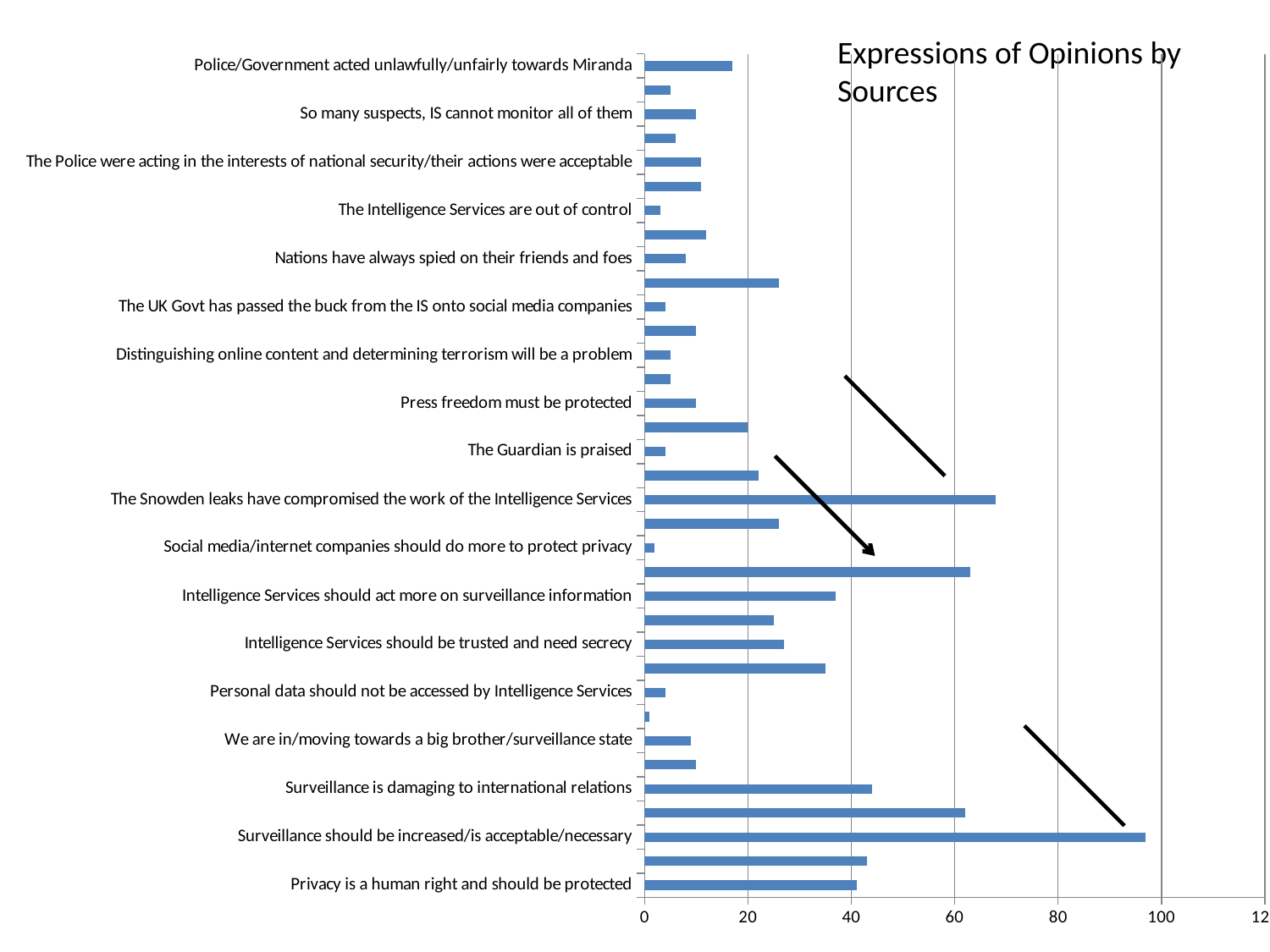
Is the value for "Privacy is a human right and should be protected" greater or less than 20? greater Is the value for "Social media/internet companies should do more to protect privacy" greater or less than 20? less What kind of chart is shown on the slide? bar chart Is the value for "The Intelligence Services are out of control" greater or less than 20? less Which has the larger value: "The Snowden leaks have compromised the work of the Intelligence Services" or "Surveillance is damaging to international relations"? The Snowden leaks have compromised the work of the Intelligence Services Which labelled opinion has the highest value? Surveillance should be increased/is acceptable/necessary Which has the larger value: "Surveillance should be increased/is acceptable/necessary" or "Privacy is a human right and should be protected"? Surveillance should be increased/is acceptable/necessary What is the title of the chart? Expressions of Opinions by Sources Which has the larger value: "Press freedom must be protected" or "The Guardian is praised"? Press freedom must be protected